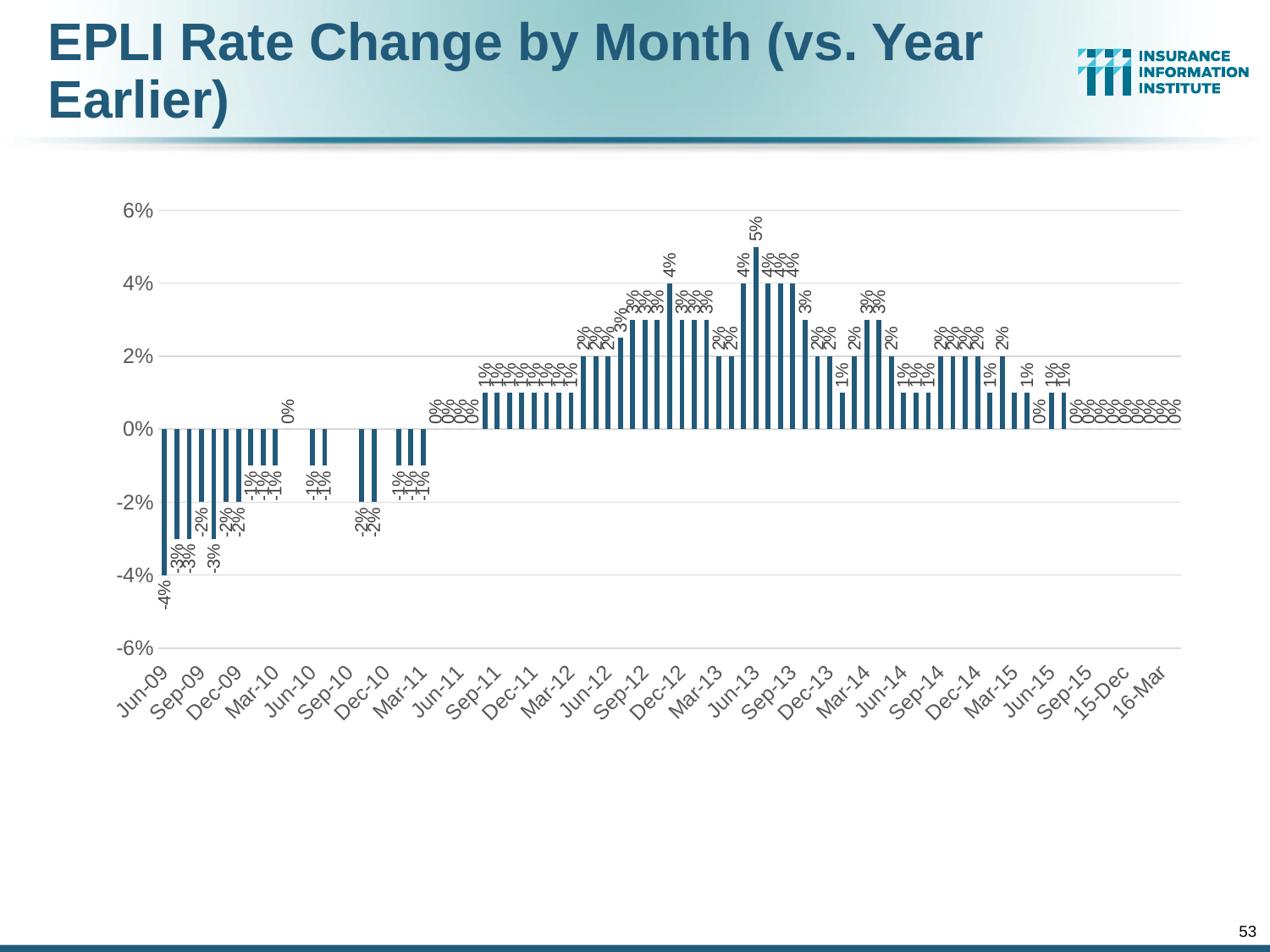
What is the maximum value shown on the y axis? 6% How many month labels are shown on the x axis? 28 What is the title of the chart? EPLI Rate Change by Month (vs. Year Earlier) Which is larger, the rate change for Jun-09 or the rate change for 16-Mar? 16-Mar What is the rate change for Jun-09, the first bar in the chart? -4% What is the lowest rate change value shown in the chart? -4% What type of chart is shown on the slide? bar chart Do the rate changes generally rise or fall from Jun-09 to mid-2013? rise Is the rate change for Jun-09 greater or less than -2%? less What is the highest rate change value shown in the chart? 5% What is the rate change for 16-Mar, the last bar in the chart? 0% What is the difference in percentage points between the highest value (5%) and the lowest value (-4%) in the chart? 9 percentage points